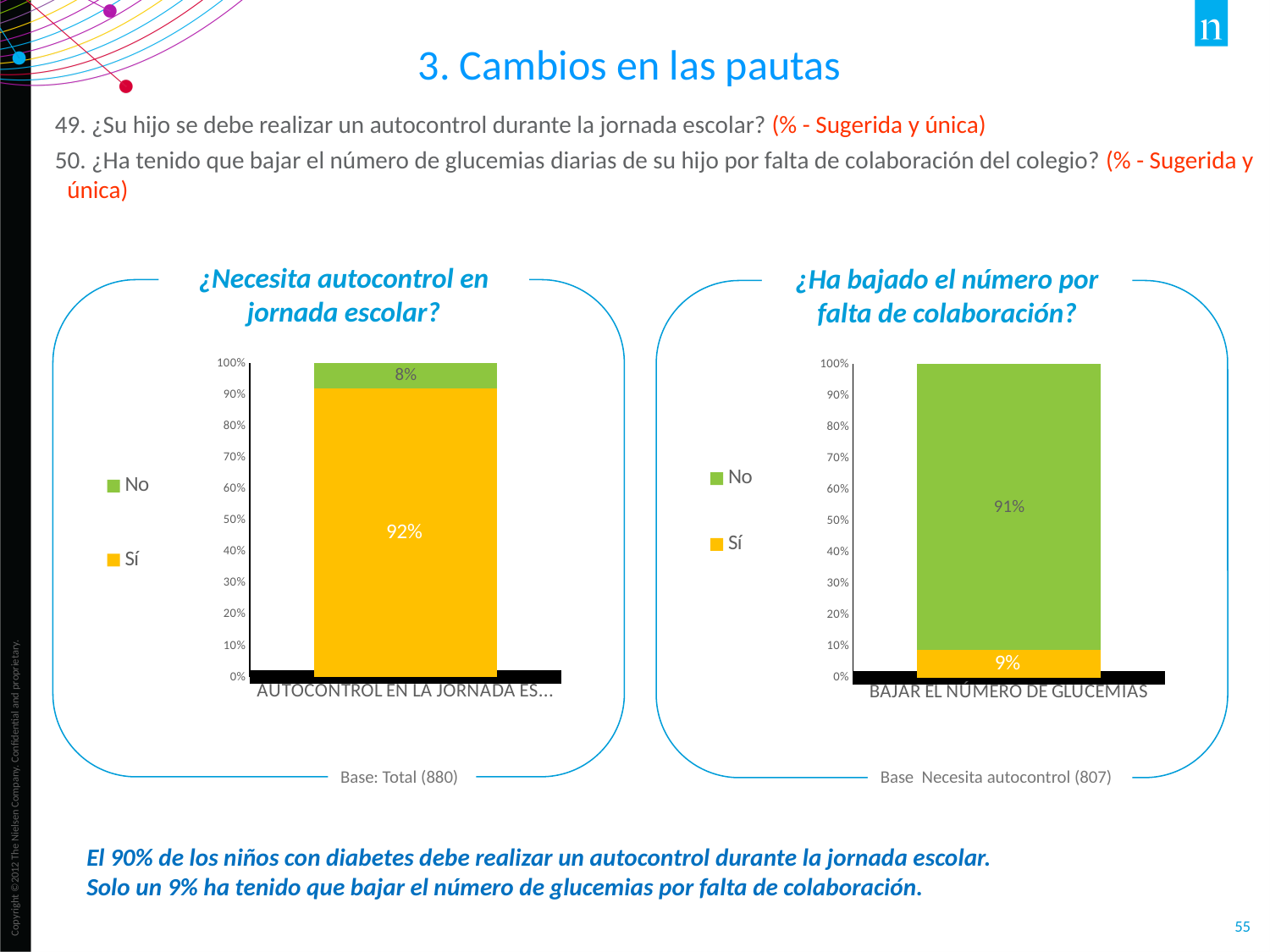
In the chart titled '¿Necesita autocontrol en jornada escolar?', which series has the larger value, 'Sí' or 'No'? Sí In the chart titled '¿Ha bajado el número por falta de colaboración?', what is the difference between the 'No' and 'Sí' values? 82% In the chart titled '¿Necesita autocontrol en jornada escolar?', what is the value for 'Sí'? 92% What kind of chart is the chart titled '¿Ha bajado el número por falta de colaboración?'? Stacked bar chart In the chart titled '¿Necesita autocontrol en jornada escolar?', what colour represents 'Sí'? Yellow In the chart titled '¿Ha bajado el número por falta de colaboración?', what is the total of the stacked bar? 100% In the chart titled '¿Necesita autocontrol en jornada escolar?', what is the value for 'No'? 8% In the chart titled '¿Ha bajado el número por falta de colaboración?', what is the value for 'No'? 91% In the chart titled '¿Ha bajado el número por falta de colaboración?', what is the value for 'Sí'? 9% How many series does the legend list in the chart titled '¿Necesita autocontrol en jornada escolar?'? 2 In the chart titled '¿Ha bajado el número por falta de colaboración?', which series has the smaller value? Sí In the chart titled '¿Necesita autocontrol en jornada escolar?', what is the difference between the 'Sí' and 'No' values? 84%